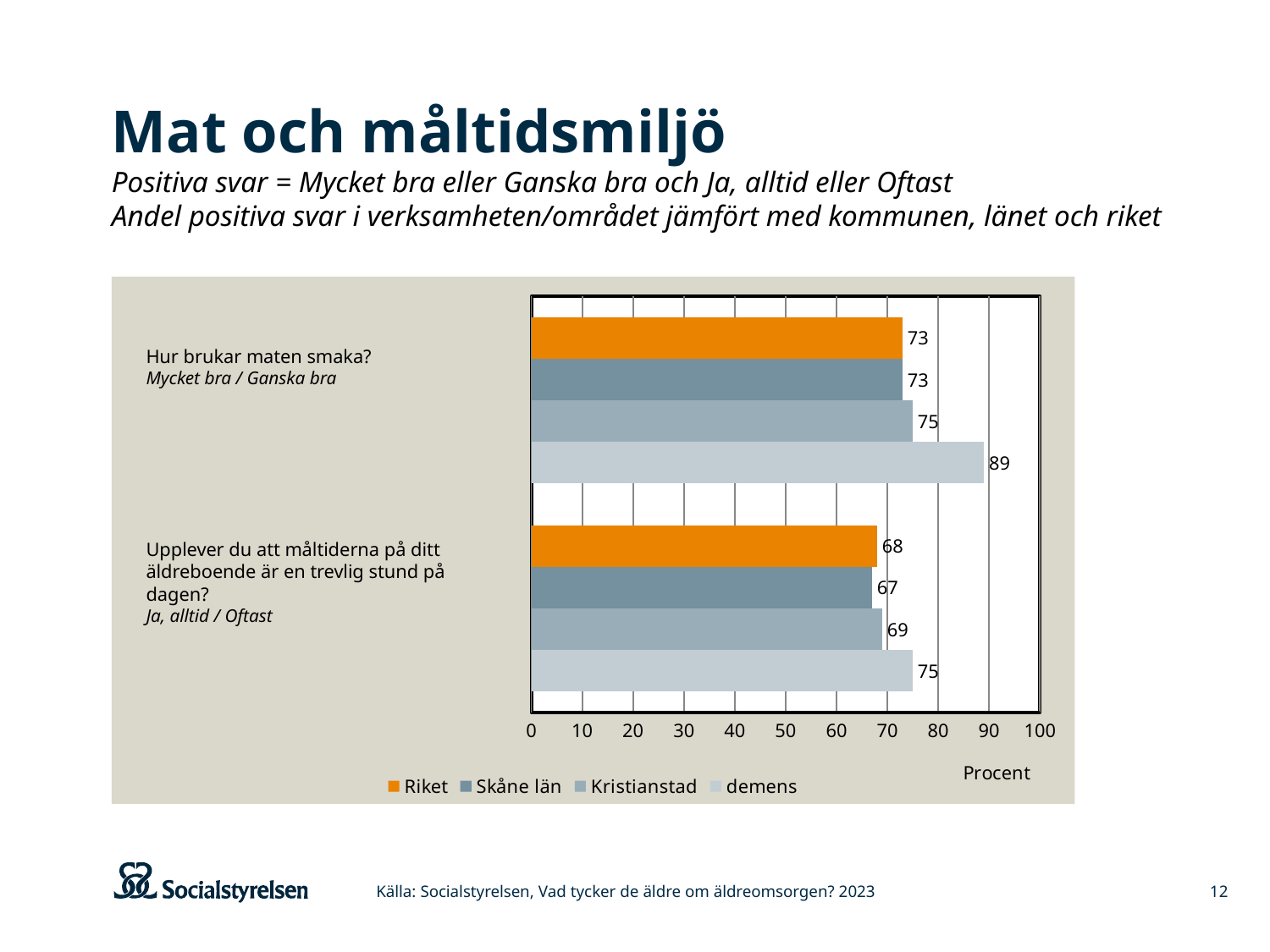
What is the difference between the demens value and the Riket value for the question "Hur brukar maten smaka?"? 16 What is the value for Skåne län for the question "Upplever du att måltiderna på ditt äldreboende är en trevlig stund på dagen?"? 67 Which is larger for the question "Upplever du att måltiderna på ditt äldreboende är en trevlig stund på dagen?": the value for demens or the value for Kristianstad? demens What is the value for Riket for the question "Upplever du att måltiderna på ditt äldreboende är en trevlig stund på dagen?"? 68 Which series has the lowest value for the question "Upplever du att måltiderna på ditt äldreboende är en trevlig stund på dagen?"? Skåne län Which series has the highest value for the question "Hur brukar maten smaka?"? demens What label is shown on the horizontal axis of the chart? Procent How many series does the legend list? 4 What is the value for demens for the question "Hur brukar maten smaka?"? 89 What kind of chart is shown on the slide? Bar chart How many question categories are shown on the chart? 2 What is the value for Kristianstad for the question "Hur brukar maten smaka?"? 75